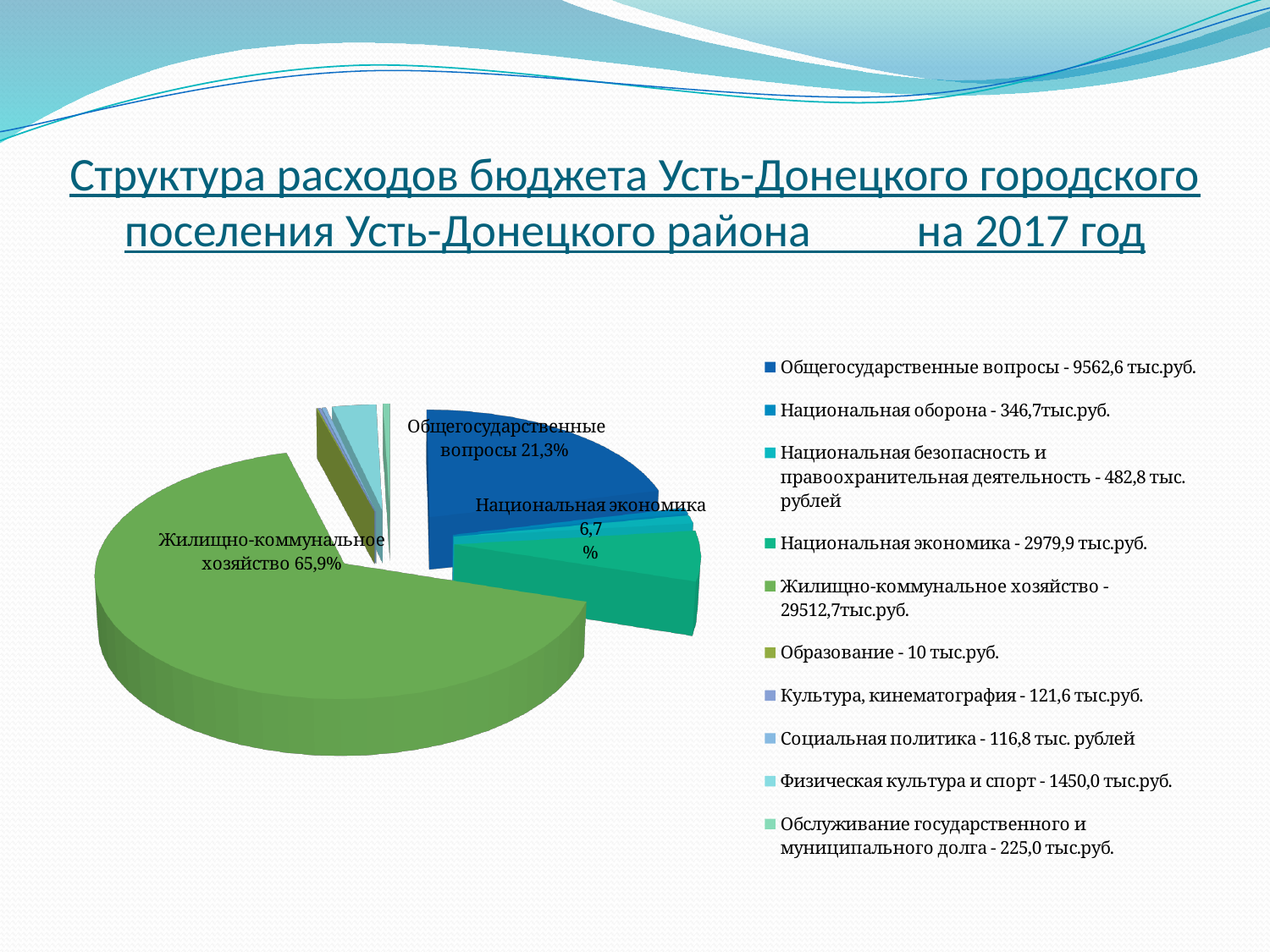
What is the expenditure for Национальная оборона according to the legend? 346,7 тыс.руб. How many categories does the legend of the pie chart list? 10 What share of the pie does Национальная экономика take? 6,7% What share of the pie does Общегосударственные вопросы take? 21,3% What share of the pie does Жилищно-коммунальное хозяйство take? 65,9% Which category has the largest slice of the pie? Жилищно-коммунальное хозяйство What kind of chart is shown on the slide? pie chart What is the expenditure for Физическая культура и спорт according to the legend? 1450,0 тыс.руб. According to the legend, which category has the smallest expenditure? Образование - 10 тыс.руб. What is the title of the slide containing the pie chart? Структура расходов бюджета Усть-Донецкого городского поселения Усть-Донецкого района на 2017 год Which is larger: the expenditure for Культура, кинематография or for Социальная политика? Культура, кинематография What is the difference between the expenditure for Общегосударственные вопросы and Национальная оборона, in тыс.руб.? 9215,9